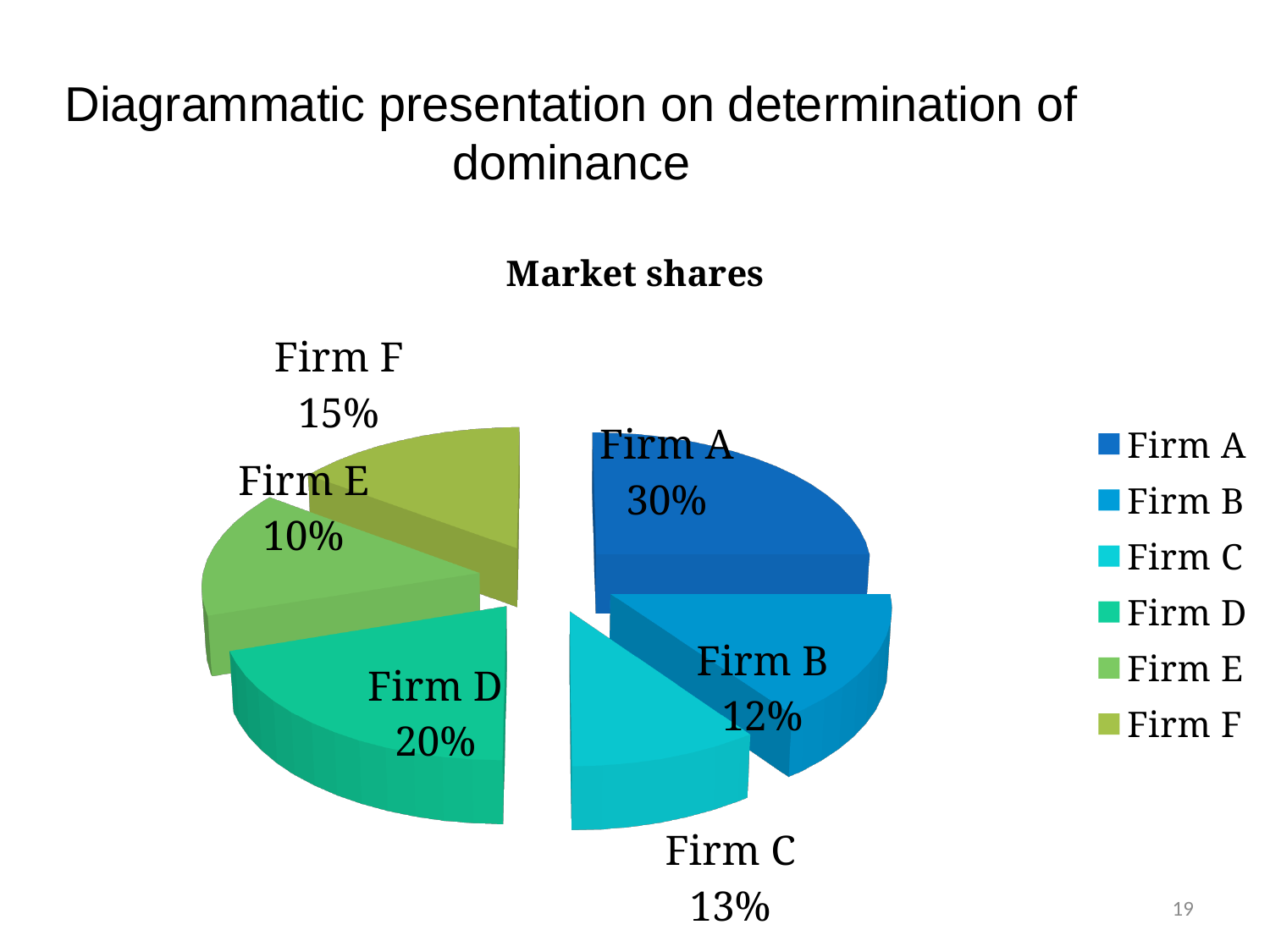
What is the market share of Firm C? 13% What kind of chart is shown on the slide? Pie chart What is the difference between the market shares of Firm A and Firm D? 10% How many entries does the legend list? 6 What is the market share of Firm A? 30% Which firm has the smallest market share? Firm E What is the market share of Firm D? 20% What is the title of the chart? Market shares Which has a larger market share, Firm B or Firm C? Firm C Which firm has the largest market share? Firm A What is the difference between the market shares of Firm F and Firm B? 3% How many firms are shown in the pie chart? 6